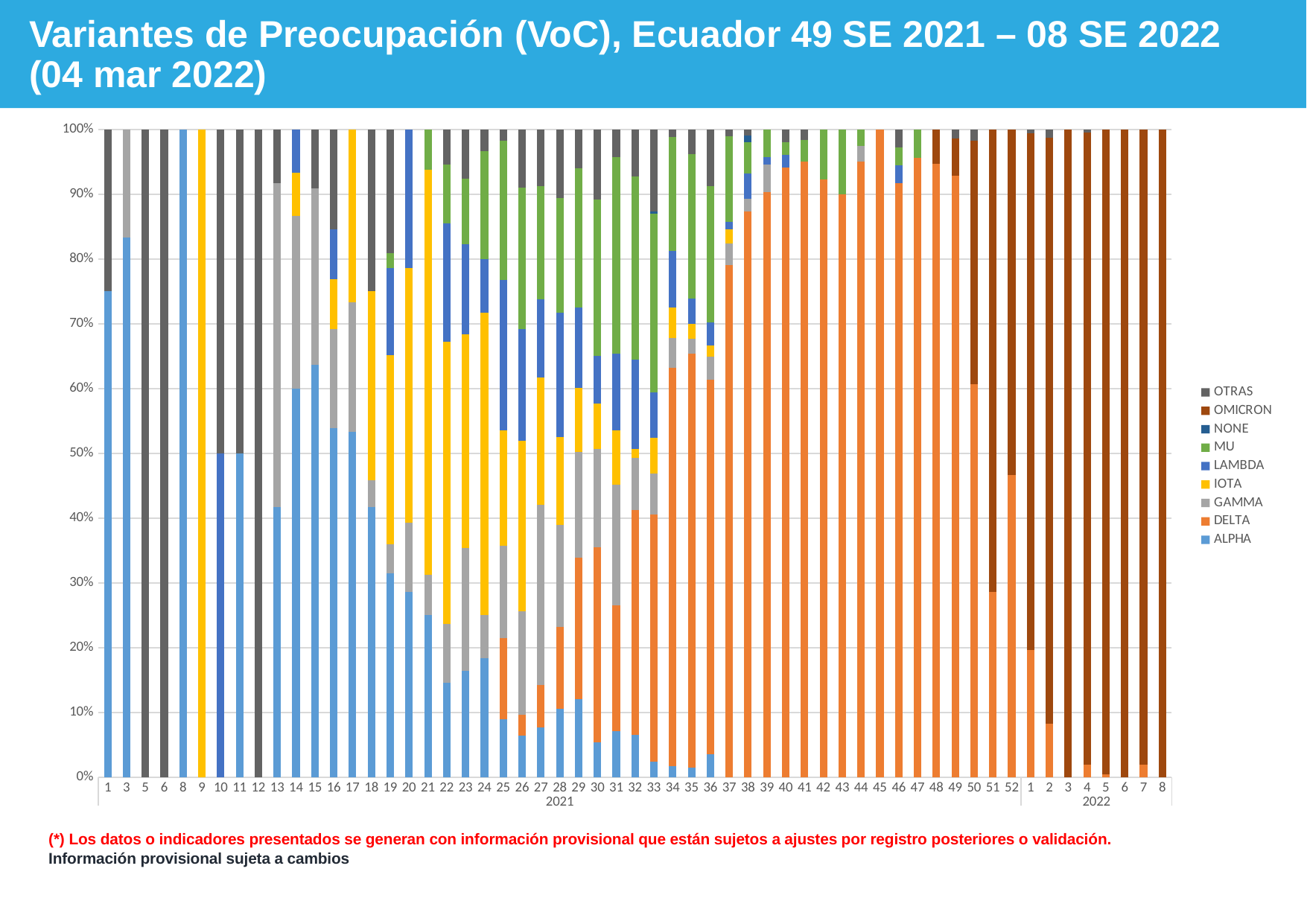
What kind of chart is shown on the slide? Stacked bar chart Does the DELTA share rise or fall from week 25 to week 45 of 2021? rise How many bars are plotted for 2022? 8 Is the ALPHA share in week 22 of 2021 greater or less than 20%? less Is the DELTA share in week 51 of 2021 greater or less than 40%? less In week 1 of 2022, which series has the larger share, OMICRON or DELTA? OMICRON Is the OMICRON share in week 1 of 2022 greater or less than 70%? greater How many series does the legend list? 9 Which series is listed first (at the top) in the legend? OTRAS Which series is listed last (at the bottom) in the legend? ALPHA